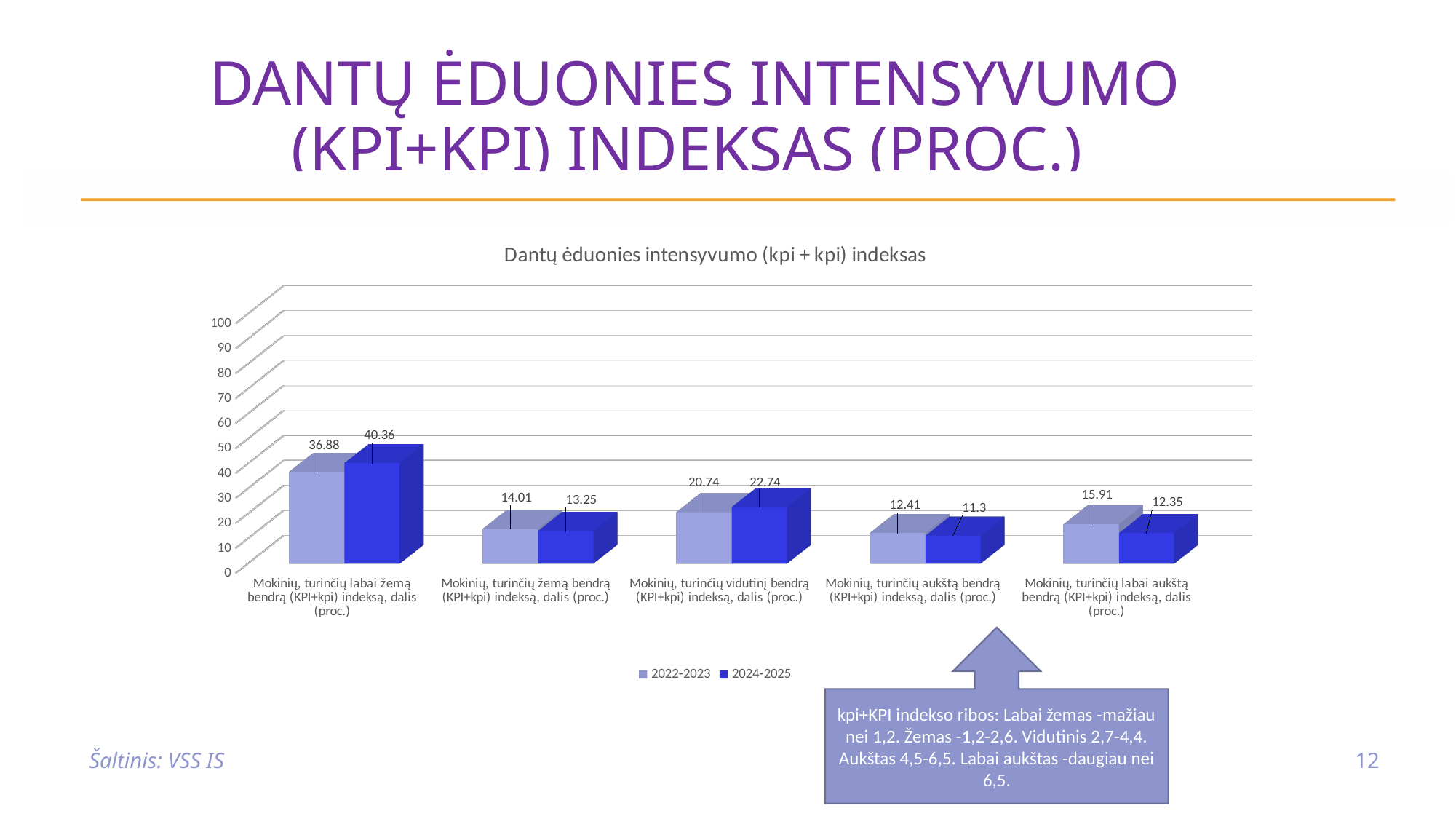
Which category has the highest 2024-2025 value? Mokinių, turinčių labai žemą bendrą (KPI+kpi) indeksą, dalis (proc.) What is the 2024-2025 value for 'Mokinių, turinčių vidutinį bendrą (KPI+kpi) indeksą, dalis (proc.)'? 22.74 What is the difference between the 2024-2025 and 2022-2023 values for 'Mokinių, turinčių labai žemą bendrą (KPI+kpi) indeksą, dalis (proc.)'? 3.48 How many categories are shown on the x axis? 5 How many series does the legend list? 2 What is the 2022-2023 value for 'Mokinių, turinčių labai žemą bendrą (KPI+kpi) indeksą, dalis (proc.)'? 36.88 What kind of chart is shown on the slide? Bar chart What is the 2022-2023 value for 'Mokinių, turinčių labai aukštą bendrą (KPI+kpi) indeksą, dalis (proc.)'? 15.91 Is the 2022-2023 value for 'Mokinių, turinčių žemą bendrą (KPI+kpi) indeksą, dalis (proc.)' greater or less than 20? less For 'Mokinių, turinčių labai aukštą bendrą (KPI+kpi) indeksą, dalis (proc.)', which series has the larger value, 2022-2023 or 2024-2025? 2022-2023 Which category has the lowest 2022-2023 value? Mokinių, turinčių aukštą bendrą (KPI+kpi) indeksą, dalis (proc.) What is the 2024-2025 value for 'Mokinių, turinčių aukštą bendrą (KPI+kpi) indeksą, dalis (proc.)'? 11.3